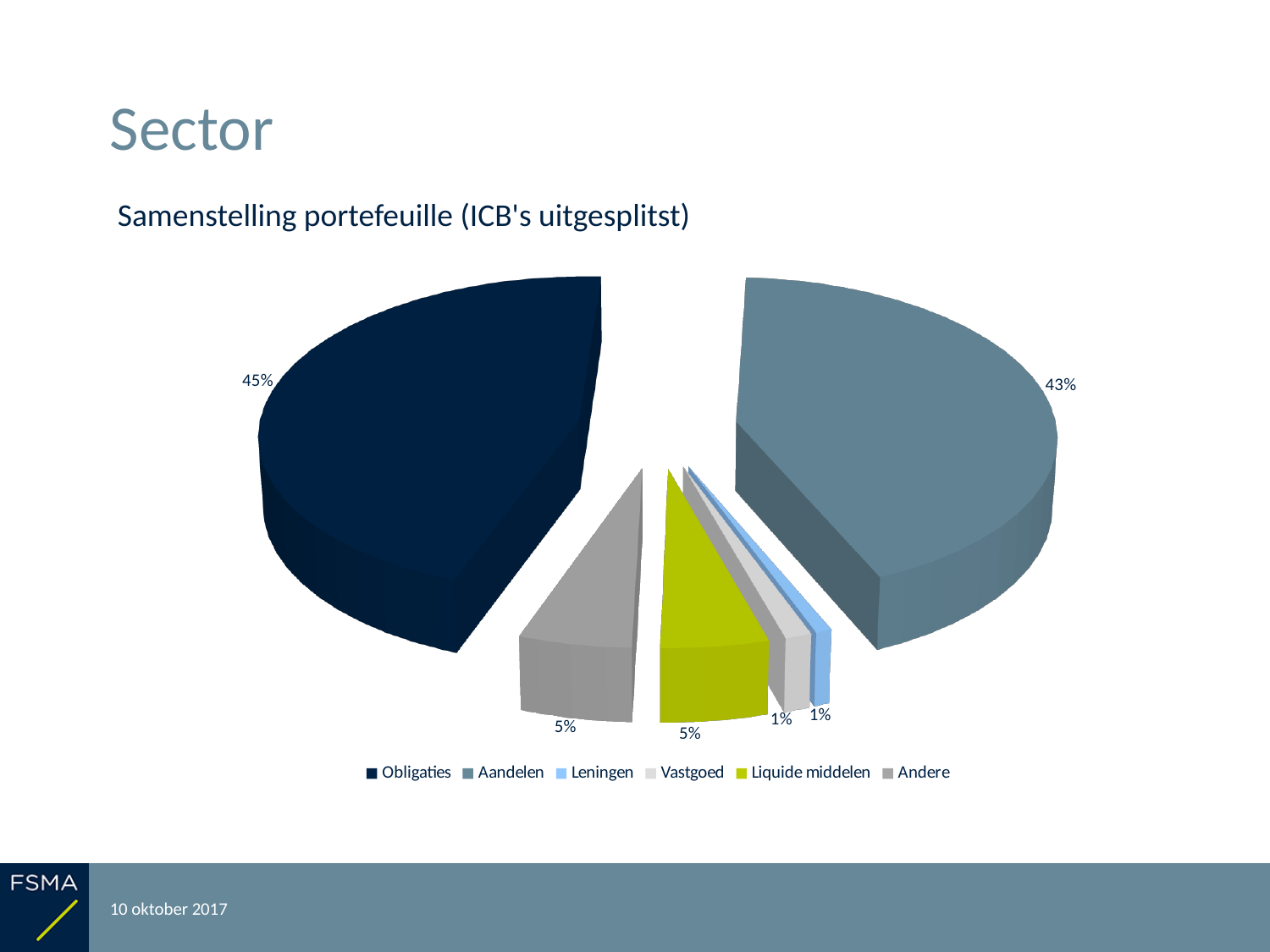
What is the title of the chart? Samenstelling portefeuille (ICB's uitgesplitst) What percentage is shown for Liquide middelen? 5% What share of the pie does Obligaties represent? 45% What share of the pie does Aandelen represent? 43% What percentage is shown for Vastgoed? 1% How many slices does the pie chart have? 6 Which category has the largest slice of the pie? Obligaties What is the difference in percentage points between the Obligaties share and the Aandelen share? 2 percentage points What kind of chart is shown on the slide? Pie chart How many entries does the legend list? 6 Which is larger, the share for Obligaties or the share for Aandelen? Obligaties What percentage is shown for Andere? 5%